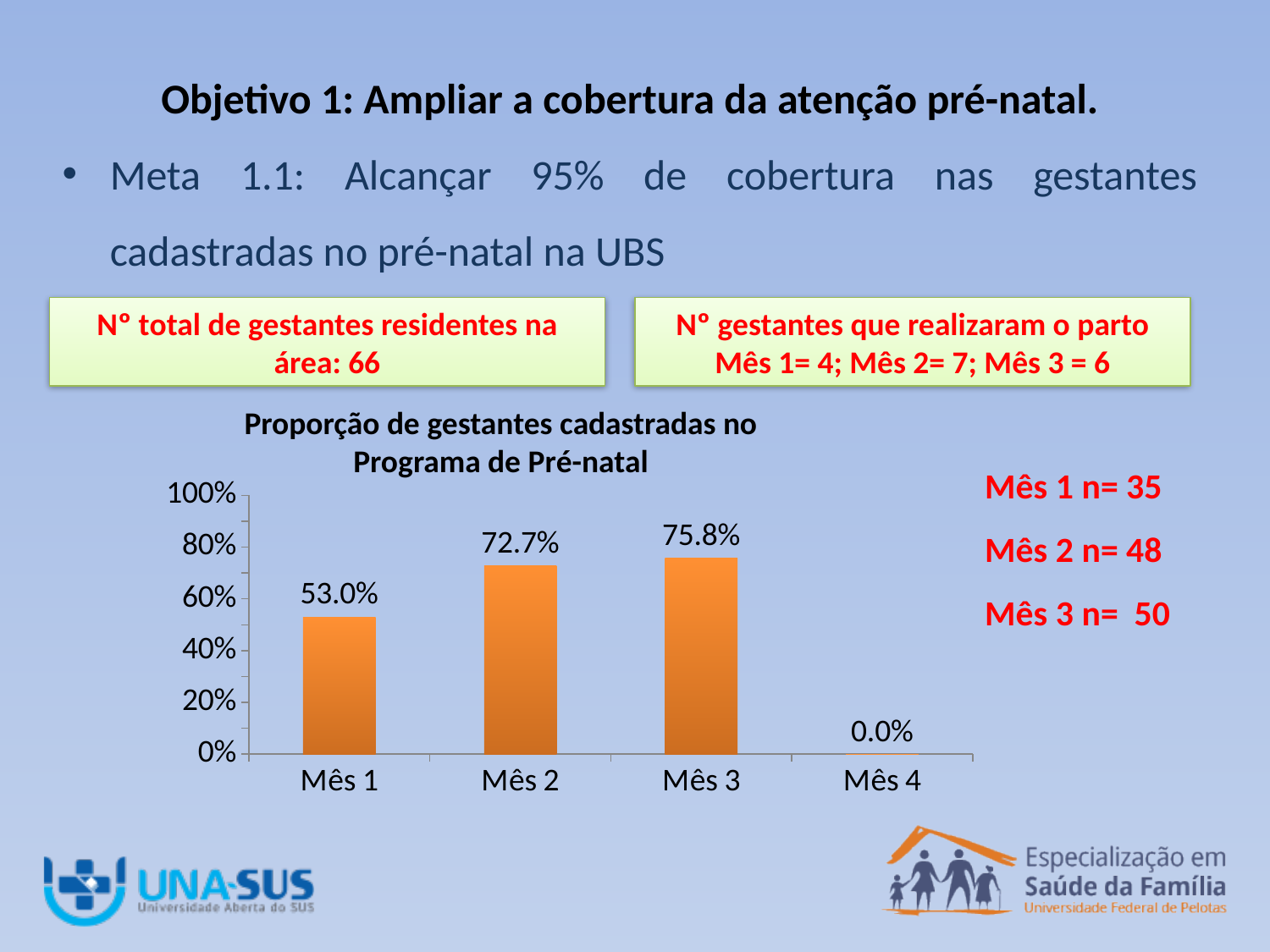
Which is larger, the value for Mês 1 or the value for Mês 2? Mês 2 Is the value for Mês 3 greater or less than 80%? less What is the value for Mês 2? 72.7% What is the value for Mês 3? 75.8% What kind of chart is shown? bar chart What is the value for Mês 4? 0.0% What is the value for Mês 1? 53.0% What is the title of the chart? Proporção de gestantes cadastradas no Programa de Pré-natal Which month has the lowest proportion? Mês 4 Which month has the highest proportion? Mês 3 How many months are shown on the x axis? 4 What is the difference between the values for Mês 2 and Mês 1? 19.7%